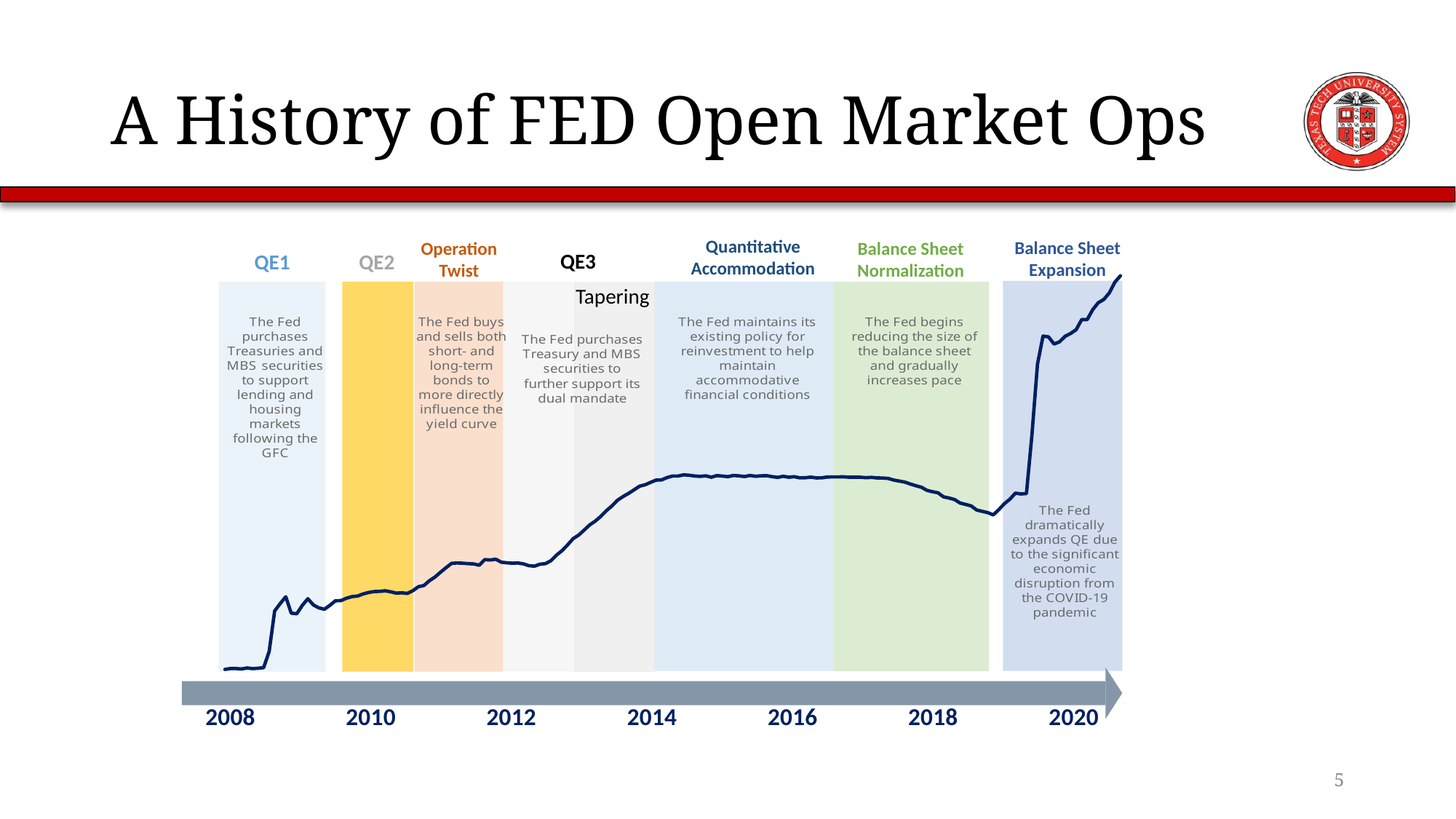
What kind of chart is shown on the slide? line chart How many labeled policy periods are marked above the chart (QE1 through Balance Sheet Expansion)? 8 During the QE3 period, does the plotted line rise or fall? rise What is the first year labeled on the x axis? 2008 What is the last year labeled on the x axis? 2020 Is the plotted line higher in 2020 or in 2008? 2020 Which labeled period on the chart is shaded yellow? QE2 What is the title of the slide containing the chart? A History of FED Open Market Ops Overall, does the plotted line rise or fall from 2008 to 2020? rise During the Balance Sheet Normalization period, does the plotted line rise or fall? fall How many year labels are shown along the x axis of the chart? 7 Is the plotted line higher during the Quantitative Accommodation period or during the QE1 period? Quantitative Accommodation